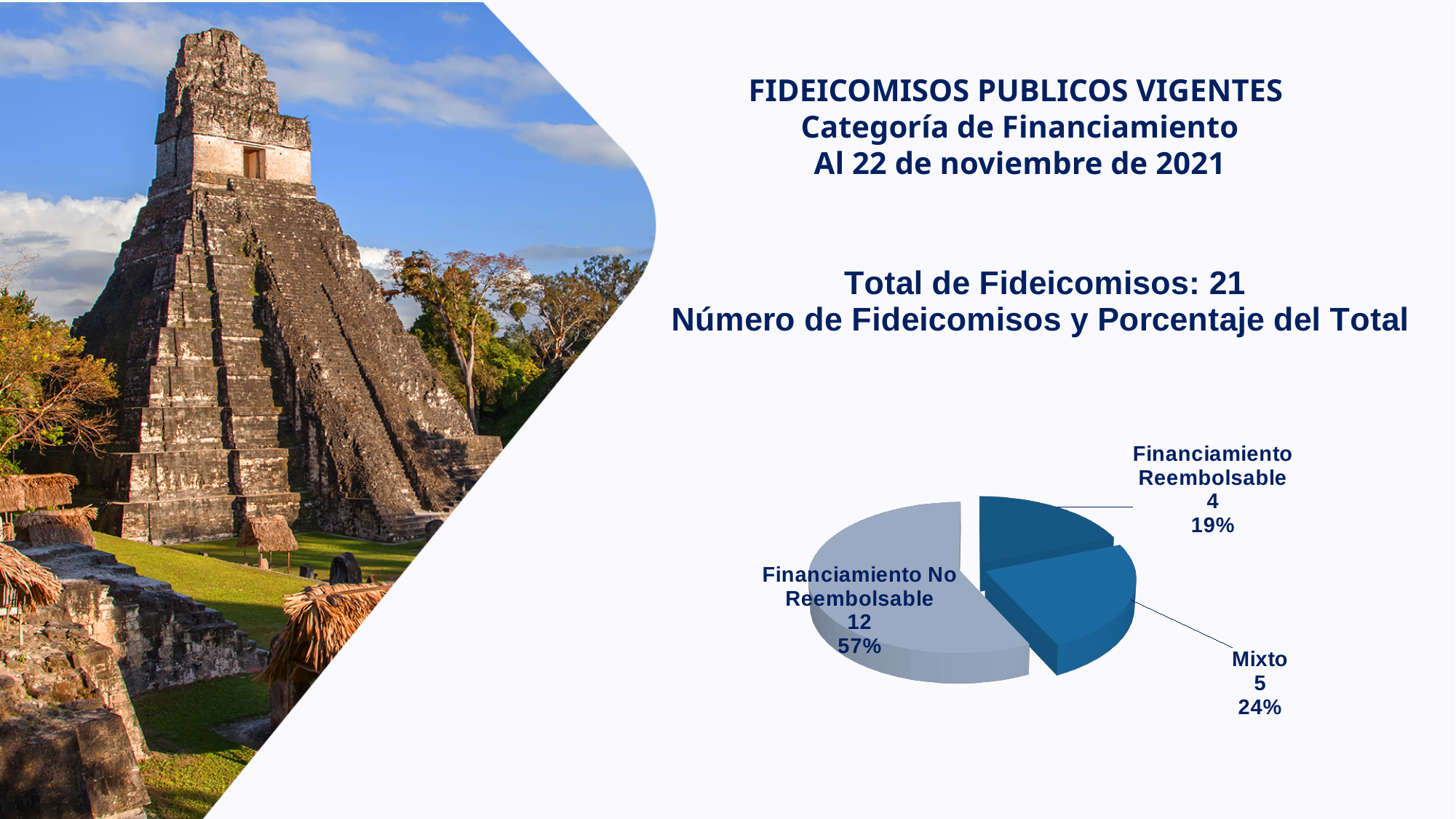
What kind of chart is shown on the slide? Pie chart Which category has the largest number of fideicomisos? Financiamiento No Reembolsable What is the difference in the number of fideicomisos between Financiamiento No Reembolsable and Mixto? 7 What percentage of the total does the Mixto slice represent? 24% What percentage of the total does the Financiamiento Reembolsable slice represent? 19% How many fideicomisos are in the Mixto category? 5 How many fideicomisos are in the Financiamiento No Reembolsable category? 12 How many fideicomisos are in the Financiamiento Reembolsable category? 4 How many slices does the pie chart have? 3 Which category has the smallest number of fideicomisos? Financiamiento Reembolsable What percentage of the total does the Financiamiento No Reembolsable slice represent? 57% What is the total number of fideicomisos stated on the slide? 21